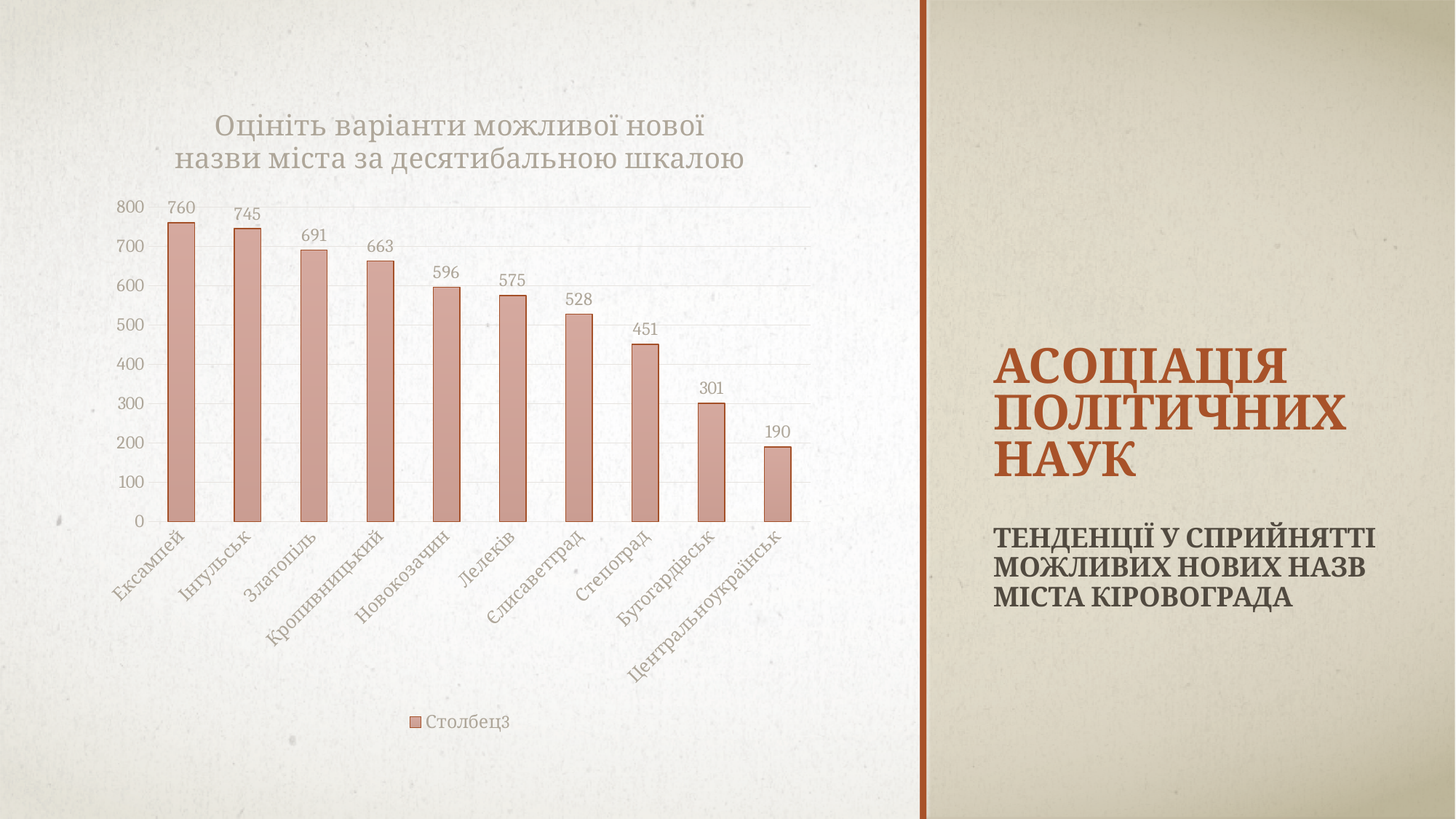
What is the value for Степоград? 451 How many categories are shown on the x axis? 10 Do the values rise or fall from left to right along the x axis? fall What kind of chart is shown on the slide? bar chart What is the value for Ексампей? 760 What is the value for Кропивницький? 663 Is the value for Новокозачин greater or less than 500? greater Which category has the highest value? Ексампей How many series does the legend list? 1 Which category has the lowest value? Центральноукраїнськ Which is larger, the value for Бугогардівськ or the value for Єлисаветград? Єлисаветград What is the difference between the values for Златопіль and Лелеків? 116